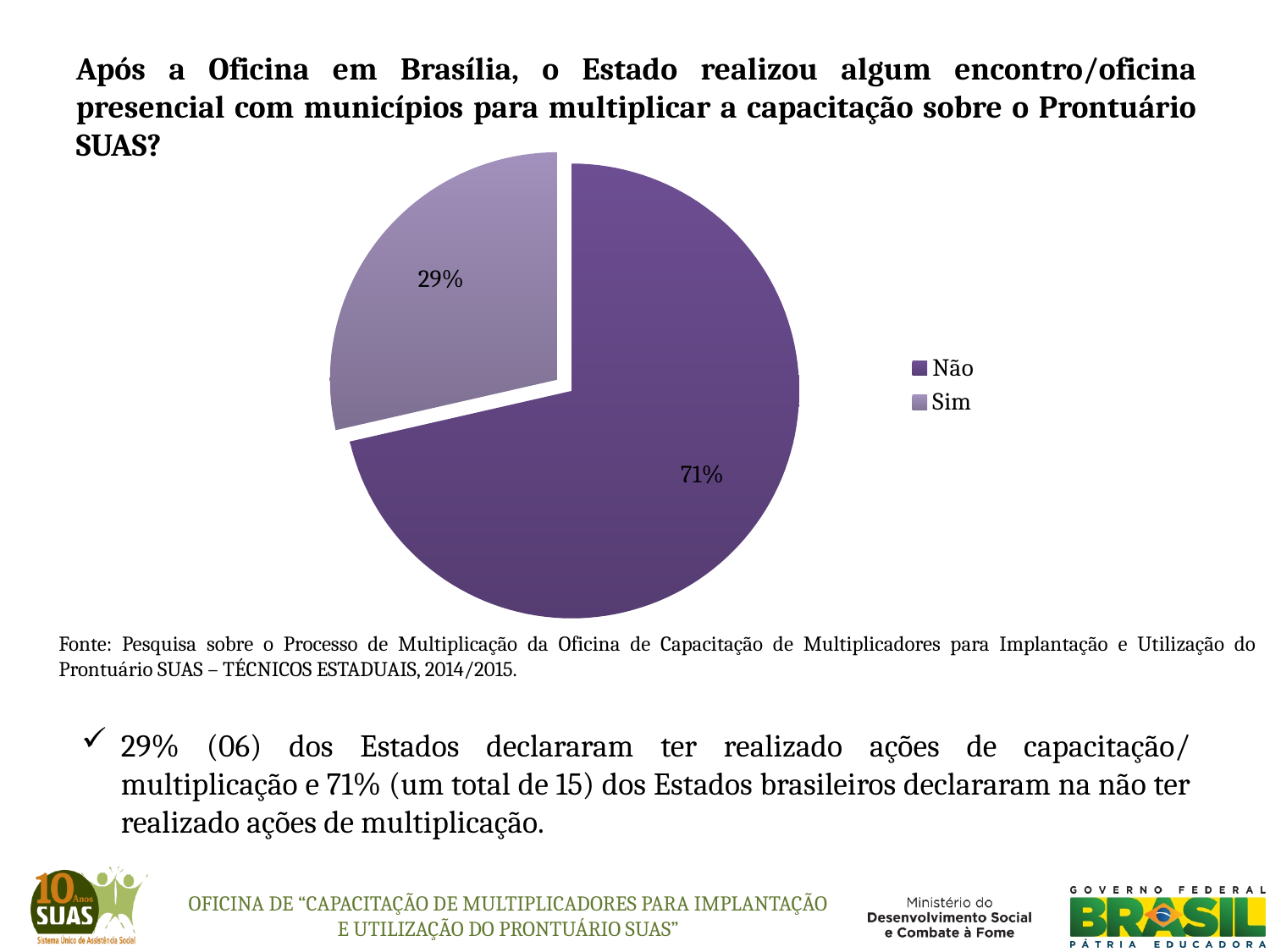
Which category has the smallest slice of the pie? Sim Which slice is pulled out (exploded) from the pie? Sim Which category has the largest slice of the pie? Não Which slice is larger, "Não" or "Sim"? Não What share of the pie does the "Sim" slice represent? 29% Which legend entry is shown in the darker purple colour? Não What kind of chart is shown on the slide? Pie chart What is the difference in percentage points between the "Não" and "Sim" slices? 42 percentage points What share of the pie does the "Não" slice represent? 71% How many slices does the pie chart have? 2 How many entries does the legend list? 2